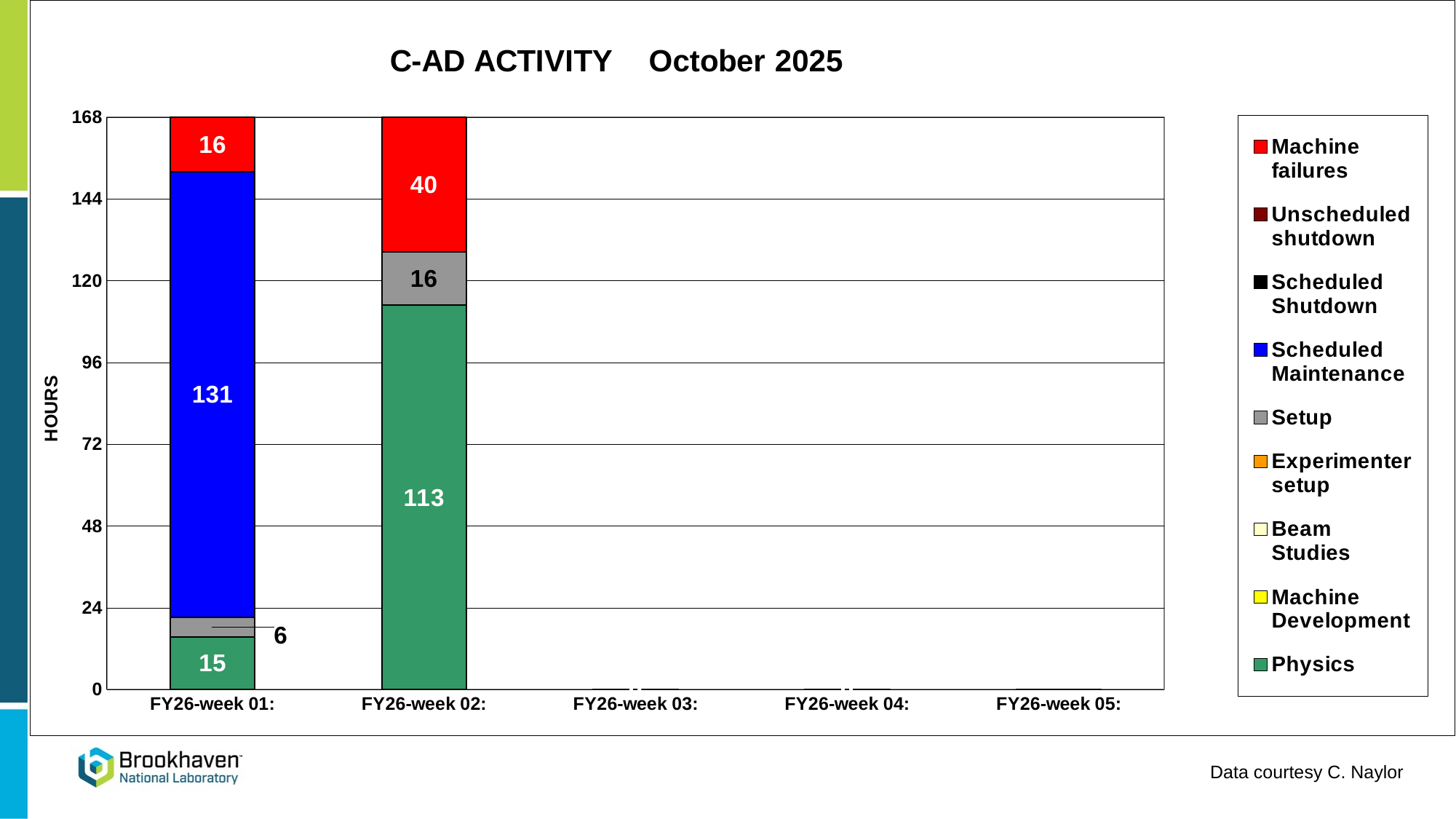
What type of chart is shown on the slide? stacked bar chart How many hours of Machine failures are shown for FY26-week 02? 40 How many hours of Scheduled Maintenance are shown for FY26-week 01? 131 What is the total height of the stacked bar for FY26-week 01? 168 How many hours of Setup are shown for FY26-week 01? 6 What is the label of the y axis? HOURS Which week has more Machine failures hours, FY26-week 01 or FY26-week 02? FY26-week 02 What is the difference in Physics hours between FY26-week 02 and FY26-week 01? 98 What is the title of the chart? C-AD ACTIVITY October 2025 How many series does the legend list? 9 How many week categories are shown on the x axis? 5 How many hours of Physics are shown for FY26-week 02? 113